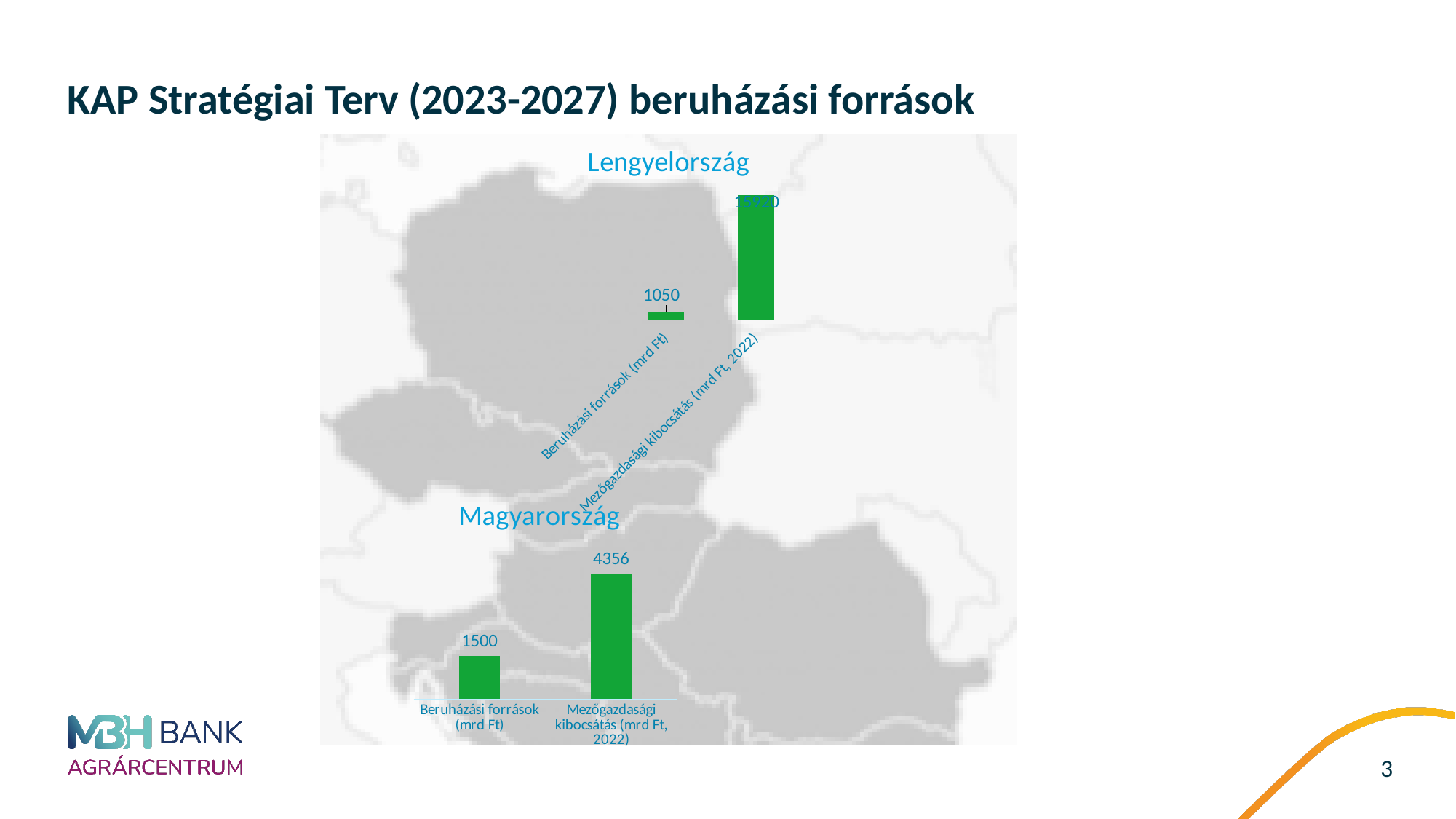
What colour are the bars in the charts on the slide? Green In the Magyarország chart, which category has the higher value? Mezőgazdasági kibocsátás (mrd Ft, 2022) In the Lengyelország chart, which category has the lower value? Beruházási források (mrd Ft) How many bars does the Magyarország chart show? 2 In the Magyarország chart, what is the difference between Mezőgazdasági kibocsátás (mrd Ft, 2022) and Beruházási források (mrd Ft)? 2856 What kind of chart is used for the Lengyelország data? Bar chart In the Lengyelország chart, what is the value for Mezőgazdasági kibocsátás (mrd Ft, 2022)? 15920 Which is larger: Beruházási források (mrd Ft) for Magyarország or Beruházási források (mrd Ft) for Lengyelország? Magyarország In the Magyarország chart, what is the value for Beruházási források (mrd Ft)? 1500 What is the title of the slide? KAP Stratégiai Terv (2023-2027) beruházási források In the Magyarország chart, what is the value for Mezőgazdasági kibocsátás (mrd Ft, 2022)? 4356 In the Lengyelország chart, what is the value for Beruházási források (mrd Ft)? 1050